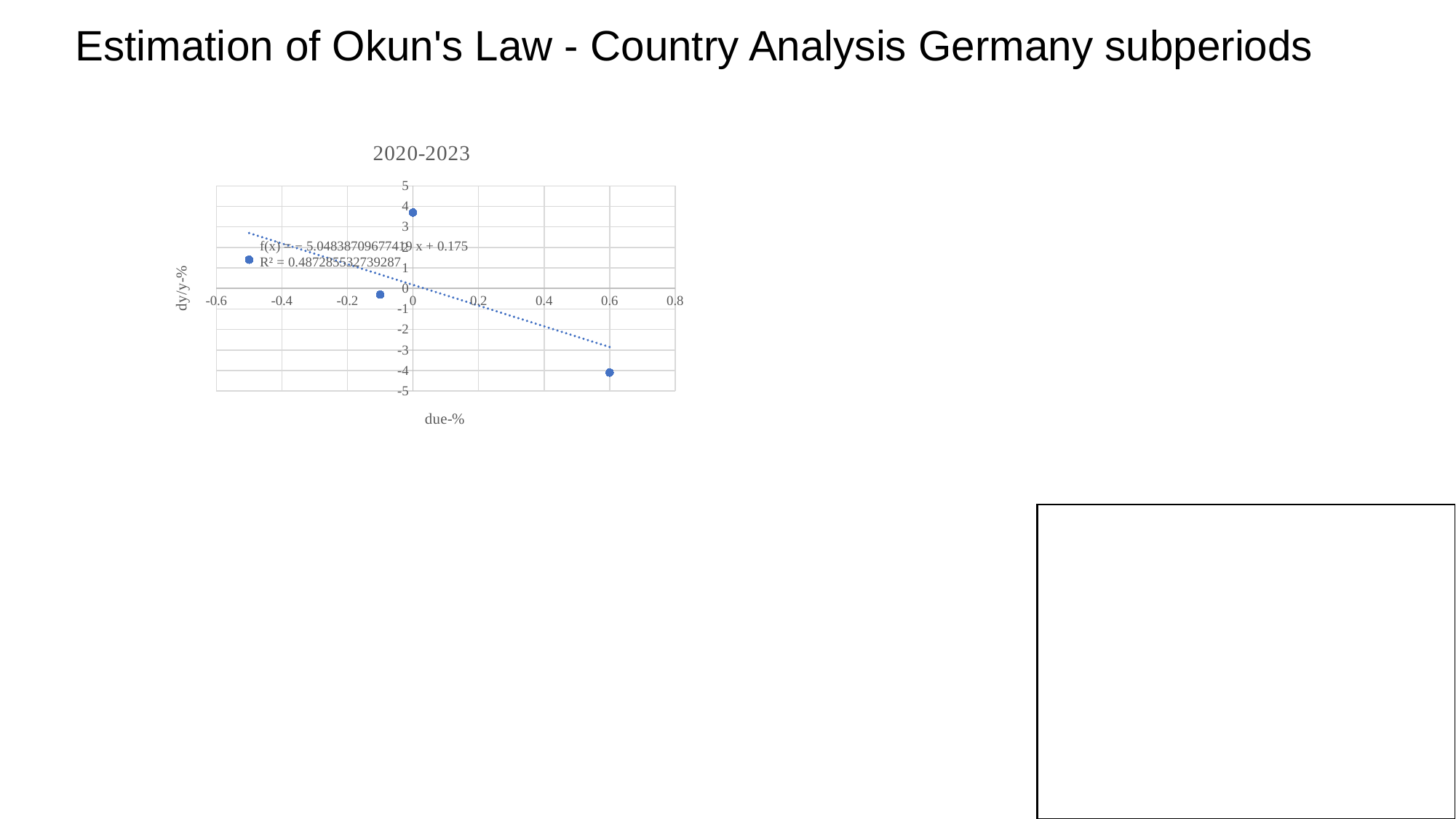
How many data points are plotted in the chart? 4 What is the intercept term shown in the trendline equation f(x)? 0.175 What kind of chart is shown on the slide? scatter chart What R² value is printed on the chart? 0.487285532739287 Which point has the lowest dy/y-% value: the one at due-% = -0.5, -0.1, 0 or 0.6? 0.6 Is the dy/y-% value of the point at due-% = -0.5 greater or less than 1? greater Does the dotted trendline rise or fall as due-% increases? fall Is the dy/y-% value of the point at due-% = 0.6 greater or less than -3? less Which point has a higher dy/y-% value: the one at due-% = -0.5 or the one at due-% = 0.6? -0.5 Is the dy/y-% value of the point at due-% = 0 greater or less than 3? greater What is the label of the x axis? due-% What is the title of the chart? 2020-2023